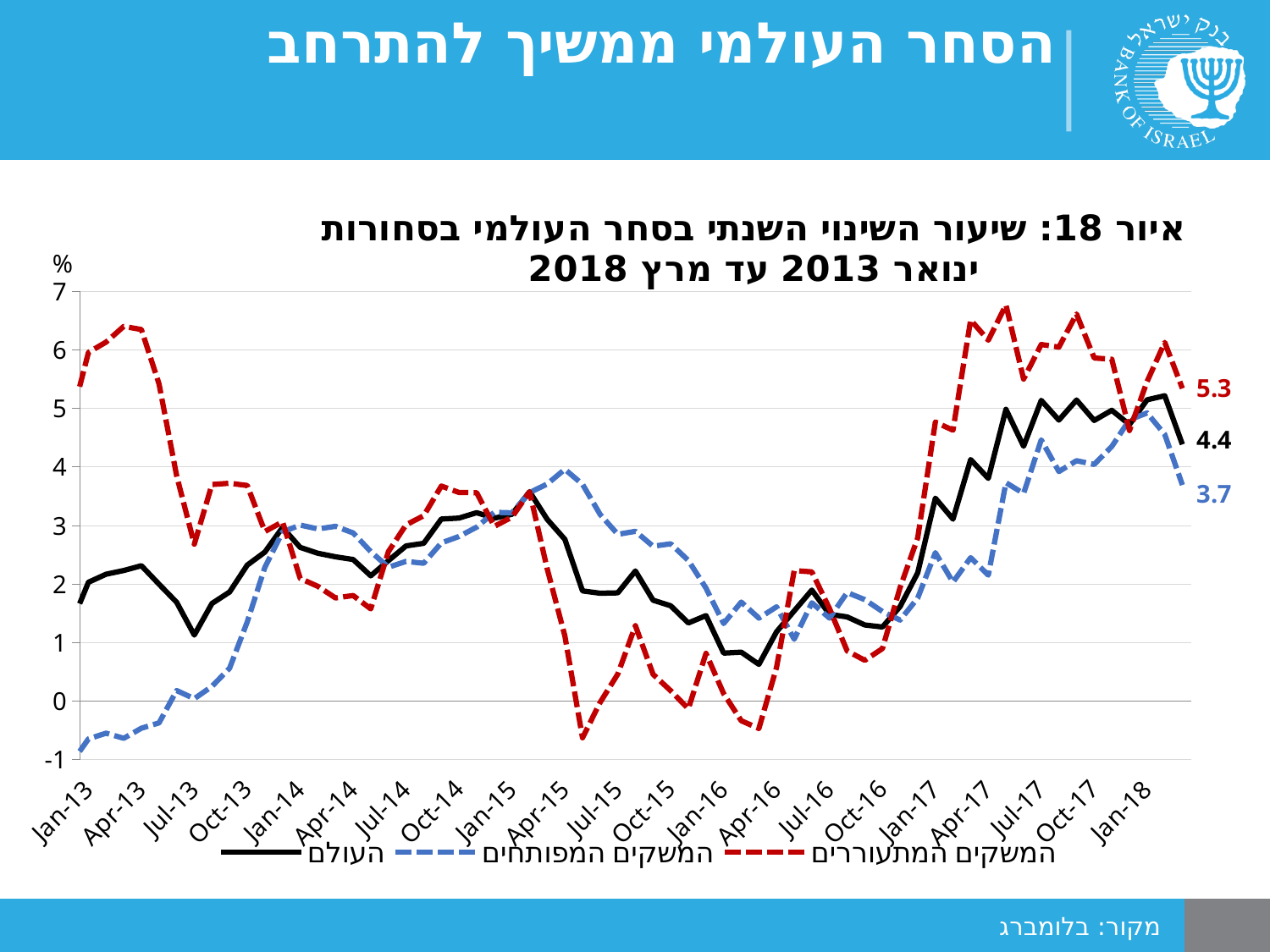
What unit is shown on the y axis of the chart? % What is the difference between the final labelled values of המשקים המתעוררים and המשקים המפותחים? 1.6 What kind of chart is shown on the slide? line chart At the end of the series, which is larger: the value for העולם or the value for המשקים המפותחים? העולם How many series does the legend list? 3 What is the final labelled value for the המשקים המתעוררים series? 5.3 What is the final labelled value for the המשקים המפותחים series? 3.7 Which series has the highest final labelled value? המשקים המתעוררים Is the value for המשקים המתעוררים at Apr-13 greater or less than 6? greater Is the value for המשקים המפותחים at Jan-13 greater or less than 0? less Which series has the lowest final labelled value? המשקים המפותחים What is the final labelled value for the העולם series? 4.4